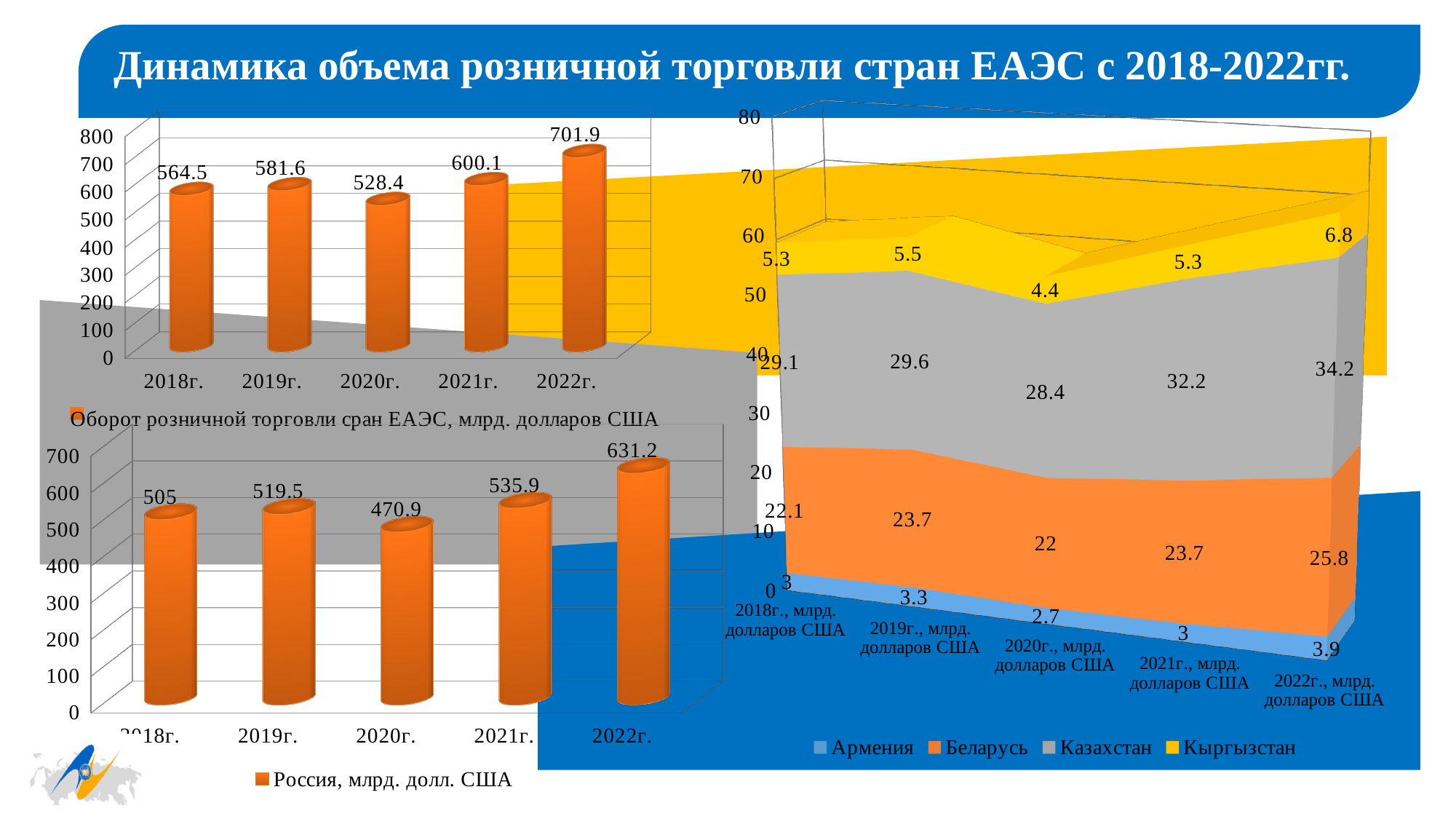
In the stacked area chart on the right, how many series does the legend list? 4 In the stacked area chart on the right, which is larger in 2019г.: Беларусь or Кыргызстан? Беларусь In the stacked area chart on the right, what is the value for Армения in 2020г.? 2.7 In the stacked area chart on the right, what is the total of all four series for 2022г.? 70.7 In the top-left bar chart (Оборот розничной торговли стран ЕАЭС), what is the difference between the 2022г. and 2018г. values? 137.4 In the stacked area chart on the right, what is the value for Казахстан in 2021г.? 32.2 In the top-left bar chart (Оборот розничной торговли стран ЕАЭС), which year has the lowest value? 2020г. In the bottom-left bar chart (Россия, млрд. долл. США), how many years are shown? 5 In the bottom-left bar chart (Россия, млрд. долл. США), which year has the highest value? 2022г. In the bottom-left bar chart (Россия, млрд. долл. США), what is the value for 2019г.? 519.5 In the bottom-left bar chart (Россия, млрд. долл. США), what is the difference between the 2022г. and 2020г. values? 160.3 In the top-left bar chart (Оборот розничной торговли стран ЕАЭС), what is the value for 2022г.? 701.9